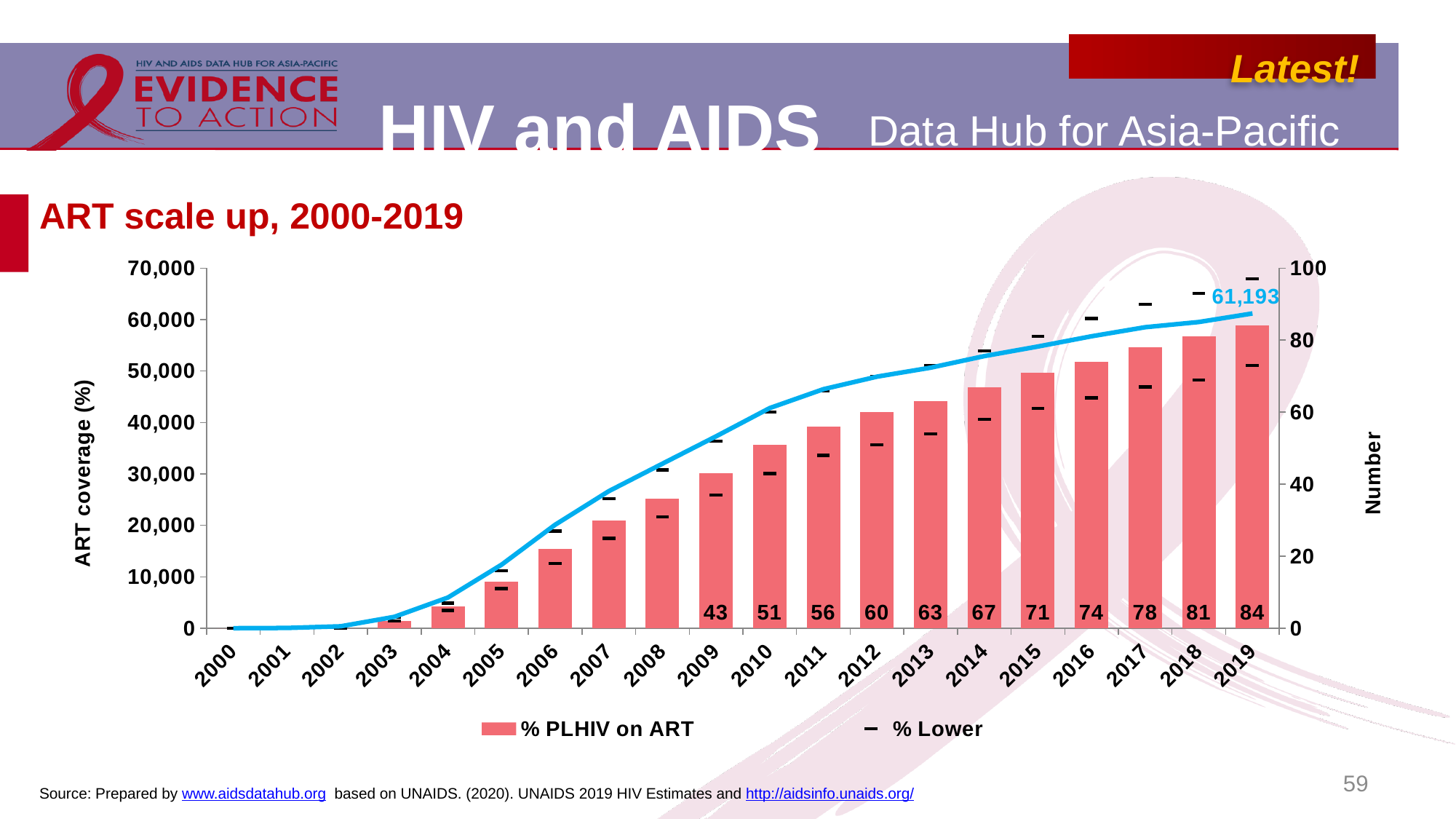
Is the value of the blue line for 2016 greater or less than 50,000? greater What is the % PLHIV on ART value shown for 2014? 67 Which year has the tallest % PLHIV on ART bar? 2019 Which year has a higher % PLHIV on ART, 2015 or 2012? 2015 What is the % PLHIV on ART value shown for 2009? 43 What is the difference between the % PLHIV on ART values for 2018 and 2017? 3 How many years are shown on the x axis? 20 By how many percentage points did % PLHIV on ART increase from 2009 to 2019? 41 What is the % PLHIV on ART value shown for 2019? 84 Do the % PLHIV on ART bars rise or fall from 2000 to 2019? rise What is the title of the chart? ART scale up, 2000-2019 What number is labelled on the blue line for 2019? 61,193